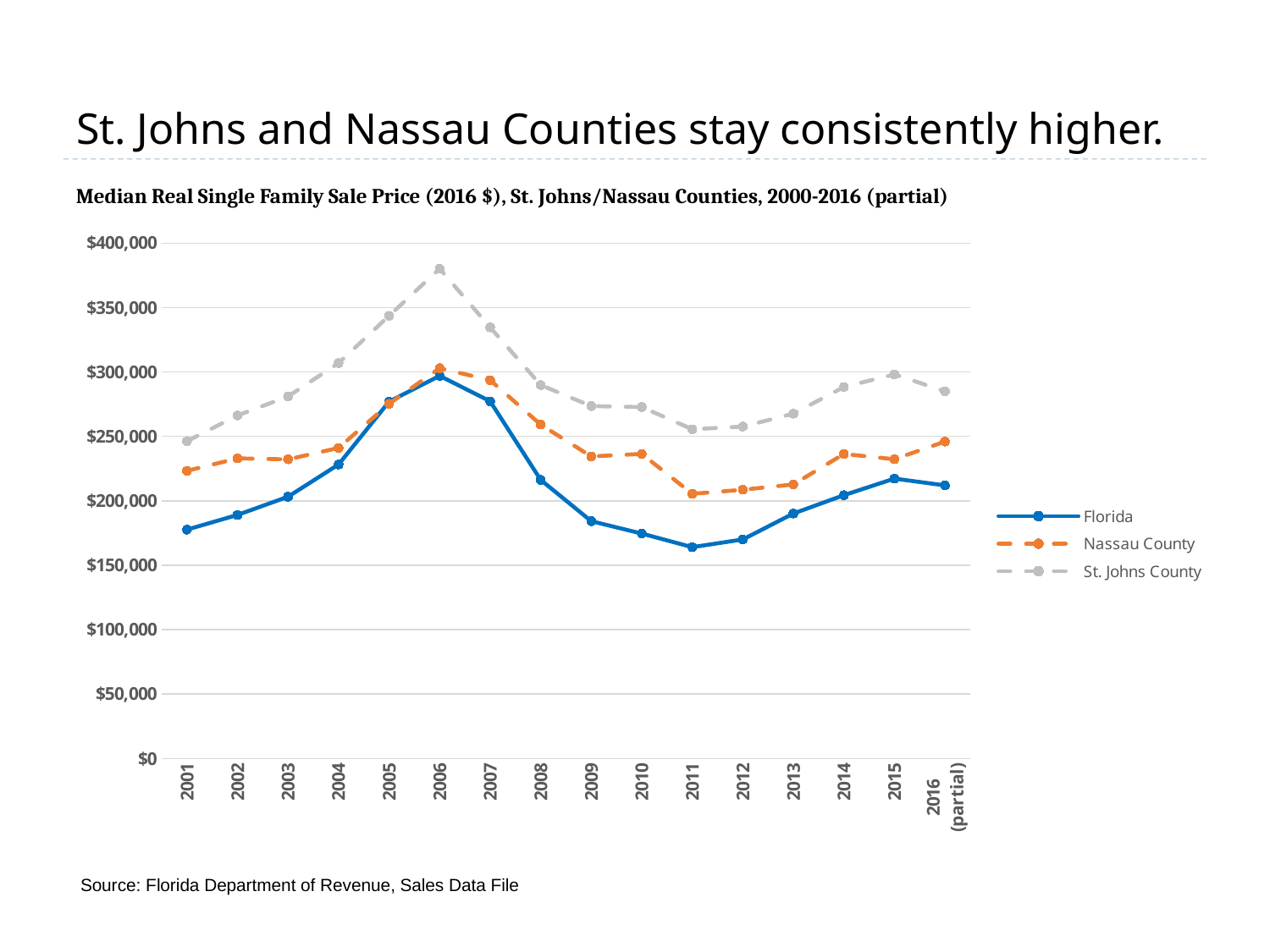
In which year does the Florida line reach its lowest value? 2011 How many series does the legend list? 3 What kind of chart is shown on the slide? Line chart In which year does the St. Johns County line reach its highest value? 2006 Which series is drawn with a solid blue line? Florida Is the value for St. Johns County in 2006 greater or less than $350,000? greater Is the value for Nassau County in 2009 greater or less than $250,000? less Is the value for Florida in 2011 greater or less than $200,000? less Does the Florida line rise or fall from 2006 to 2011? Fall In which year does the Florida line reach its highest value? 2006 Which series has the higher value in 2009, Nassau County or Florida? Nassau County How many years are plotted along the x axis? 16